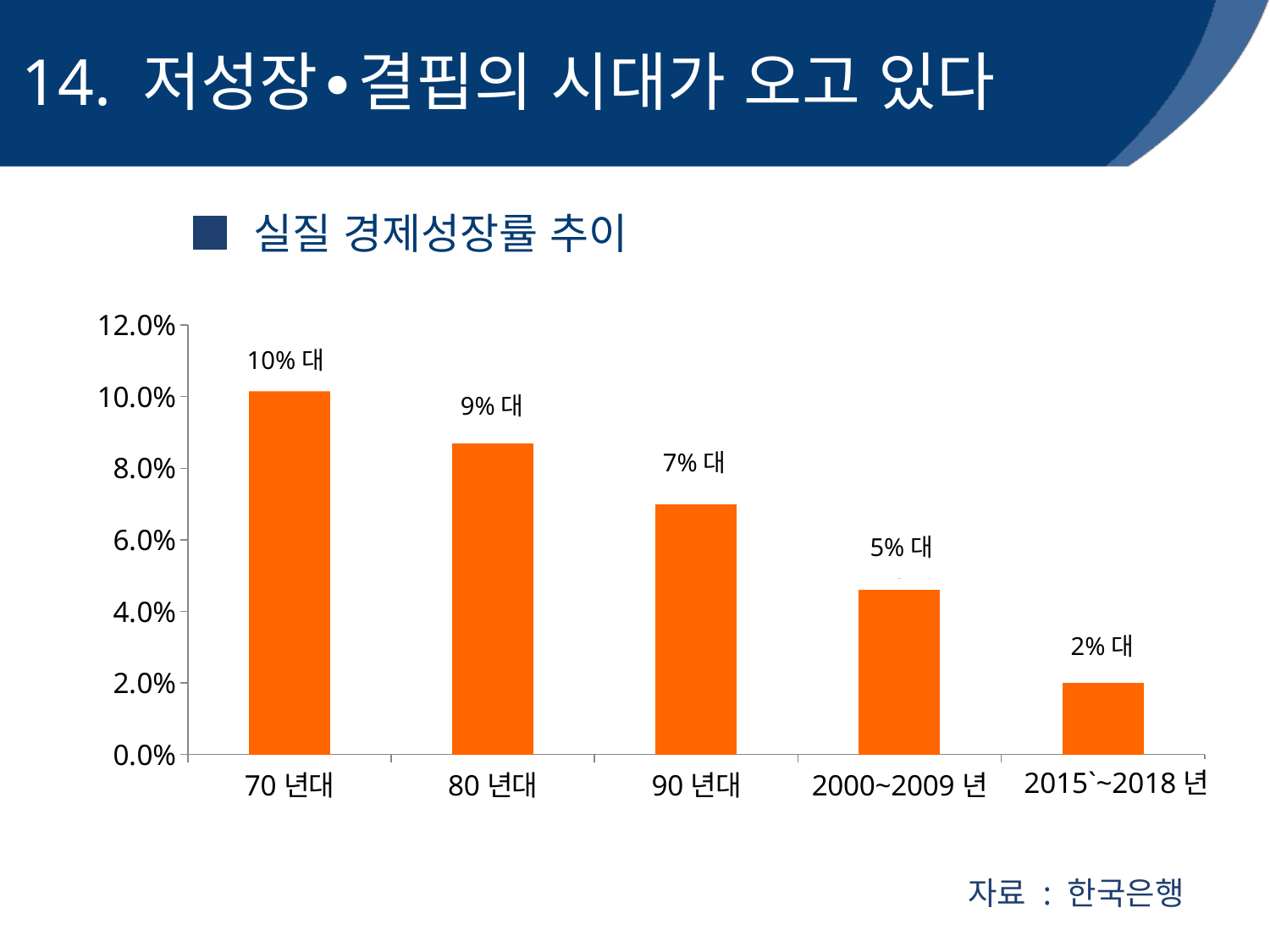
What is the data label shown for 2015`~2018 년? 2% 대 Which category has the lowest bar? 2015`~2018 년 Which category has the highest bar? 70 년대 Which is larger, the value for 80 년대 or the value for 2000~2009 년? 80 년대 What is the data label shown for 70 년대? 10% 대 What is the data label shown for 80 년대? 9% 대 What is the data label shown for 2000~2009 년? 5% 대 What is the data label shown for 90 년대? 7% 대 What kind of chart is shown on the slide? bar chart Is the value for 2015`~2018 년 greater or less than 4.0%? less Is the value for 80 년대 greater or less than 8.0%? greater How many categories are shown on the x axis? 5